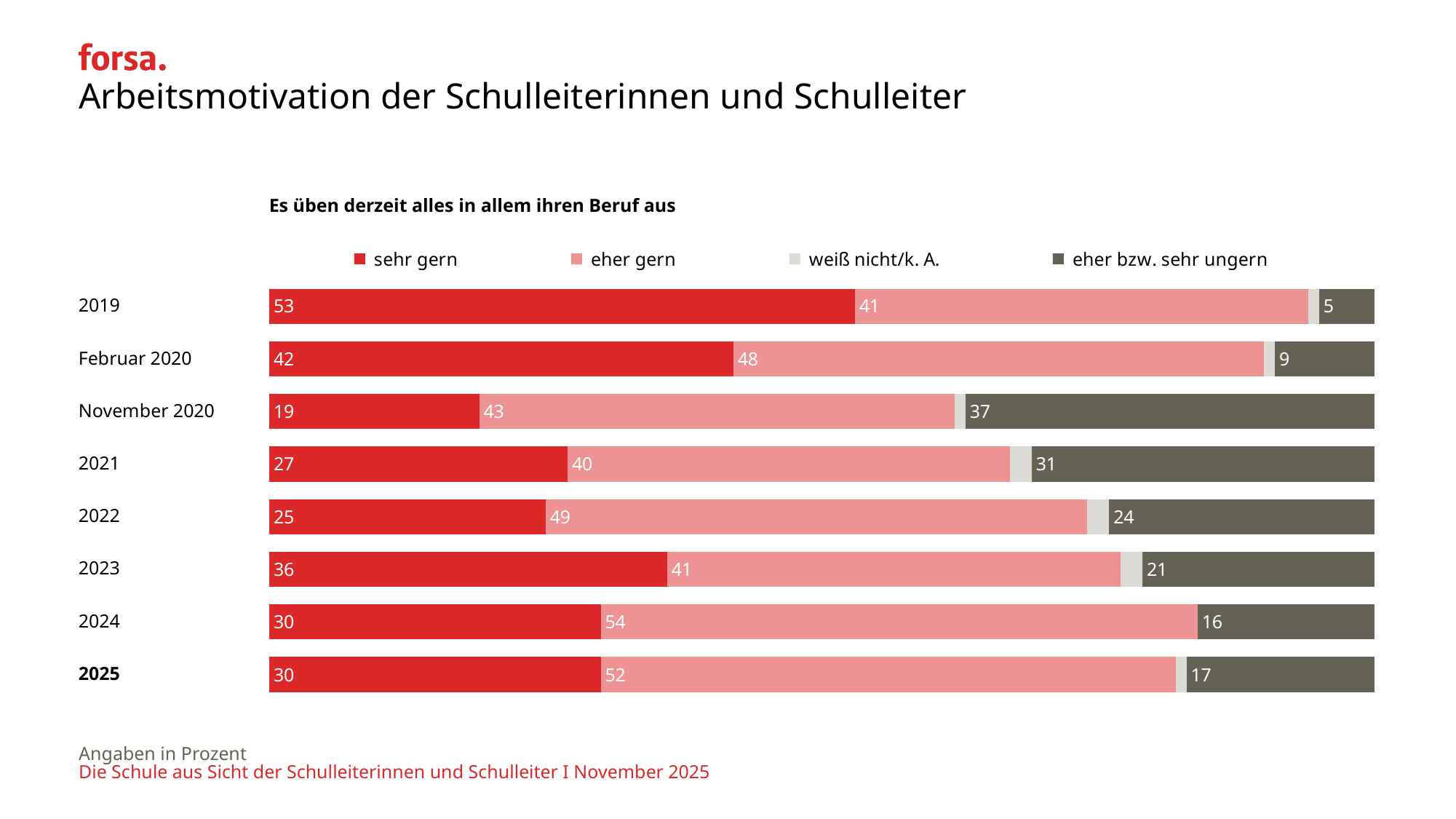
Which period has the lowest value for "eher bzw. sehr ungern"? 2019 How many time periods (categories) are shown in the chart? 8 What kind of chart is shown on the slide? stacked bar chart What is the value for "eher gern" in 2024? 54 What is the subtitle printed above the chart? Es üben derzeit alles in allem ihren Beruf aus What is the difference between the "sehr gern" values for 2019 and Februar 2020? 11 Do the "eher bzw. sehr ungern" values rise or fall from November 2020 to 2024? fall Which period has the highest value for "sehr gern"? 2019 How many series does the legend list? 4 What is the value for "sehr gern" in 2019? 53 Which is larger: the "eher gern" value for 2022 or for 2023? 2022 What is the value for "eher bzw. sehr ungern" in November 2020? 37